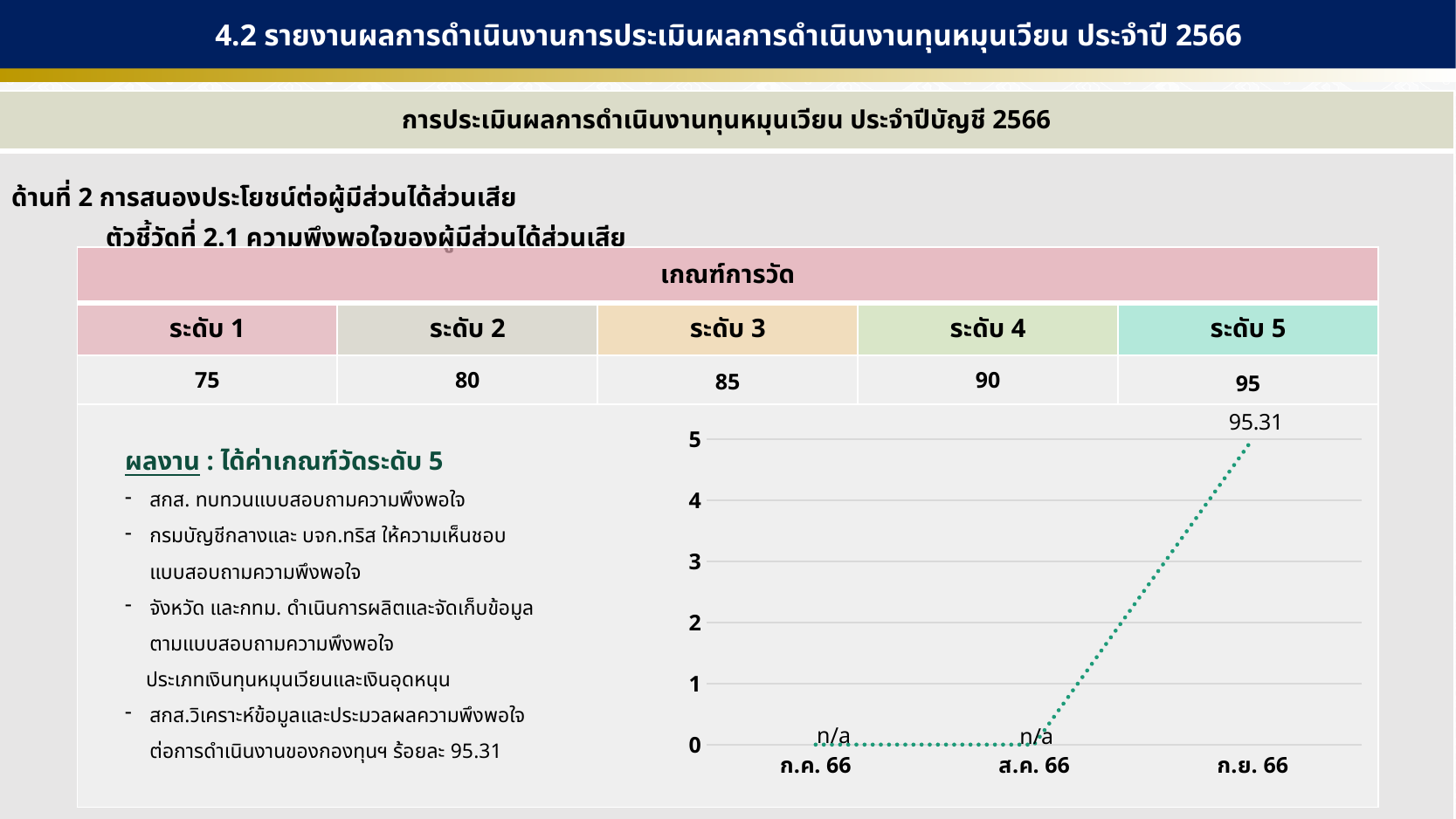
What data label is shown for ก.ค. 66 in the chart? n/a Is the plotted level for ส.ค. 66 greater or less than 1 on the y axis? less What is the label of the first category on the x axis of the chart? ก.ค. 66 What data label is shown for ส.ค. 66 in the chart? n/a What kind of chart is shown on the slide? line chart Which month has the highest point on the chart? ก.ย. 66 How many points are plotted along the x axis of the chart? 3 Which is higher on the chart, the point for ก.ค. 66 or the point for ก.ย. 66? ก.ย. 66 What data label is shown for ก.ย. 66 in the chart? 95.31 Is the plotted level for ก.ย. 66 greater or less than 4 on the y axis? greater What is the highest tick value shown on the y axis of the chart? 5 Does the line rise or fall from ส.ค. 66 to ก.ย. 66? rise